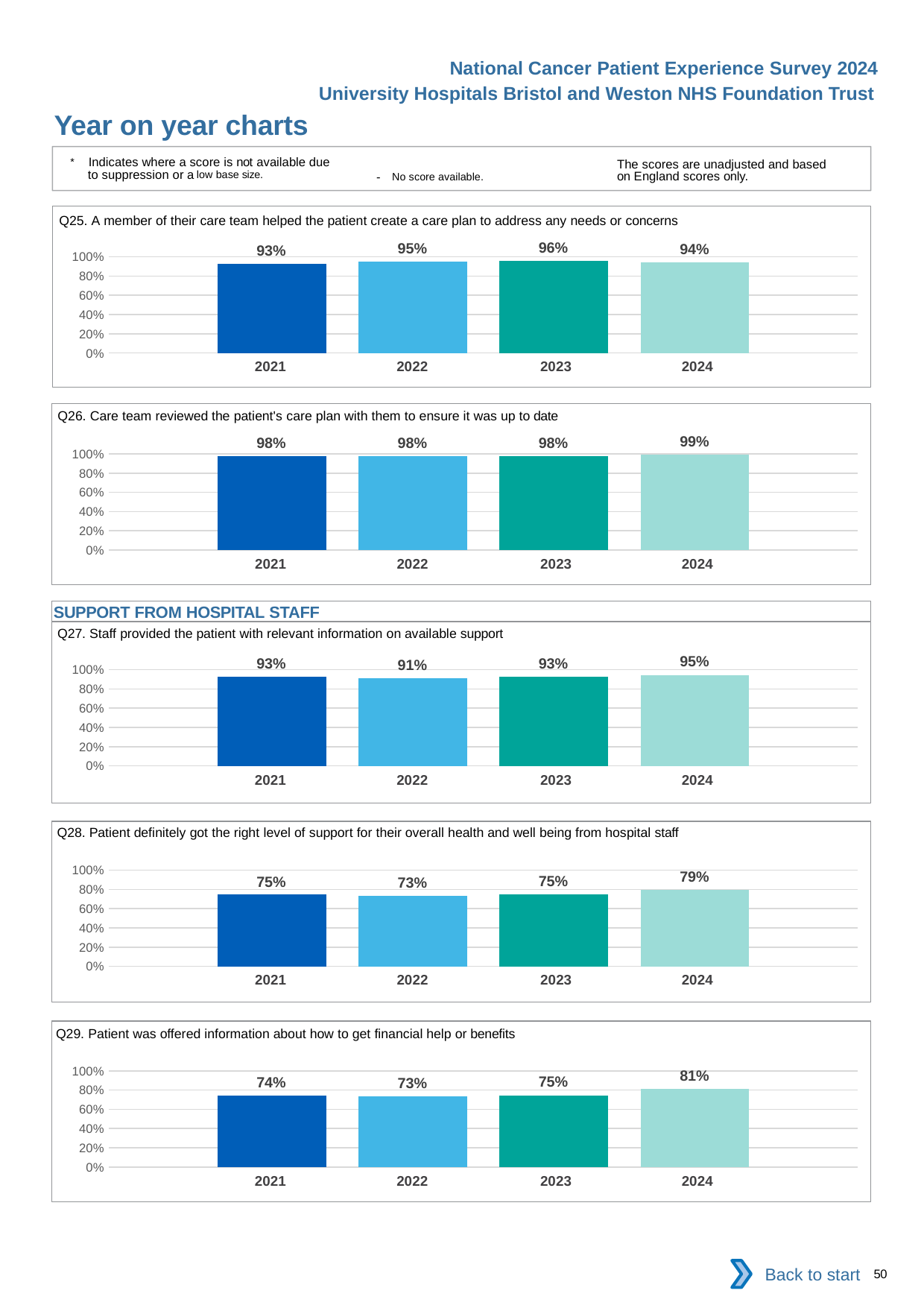
In the Q26 chart, what is the value for 2021? 98% In the Q28 chart, what is the difference between the 2024 value and the 2022 value? 6% In the Q27 chart, what is the difference between the 2024 value and the 2021 value? 2% In the Q26 chart, which year has the highest value? 2024 In the Q28 chart, is the value for 2021 greater or less than 60%? greater In the Q29 chart, what is the value for 2024? 81% In the Q29 chart, which is larger, the value for 2021 or the value for 2024? 2024 What kind of chart is the Q29 chart? bar chart In the Q25 chart, what is the value for 2023? 96% How many charts are shown on the slide? 5 How many years are shown in the Q25 chart? 4 In the Q27 chart, which year has the lowest value? 2022